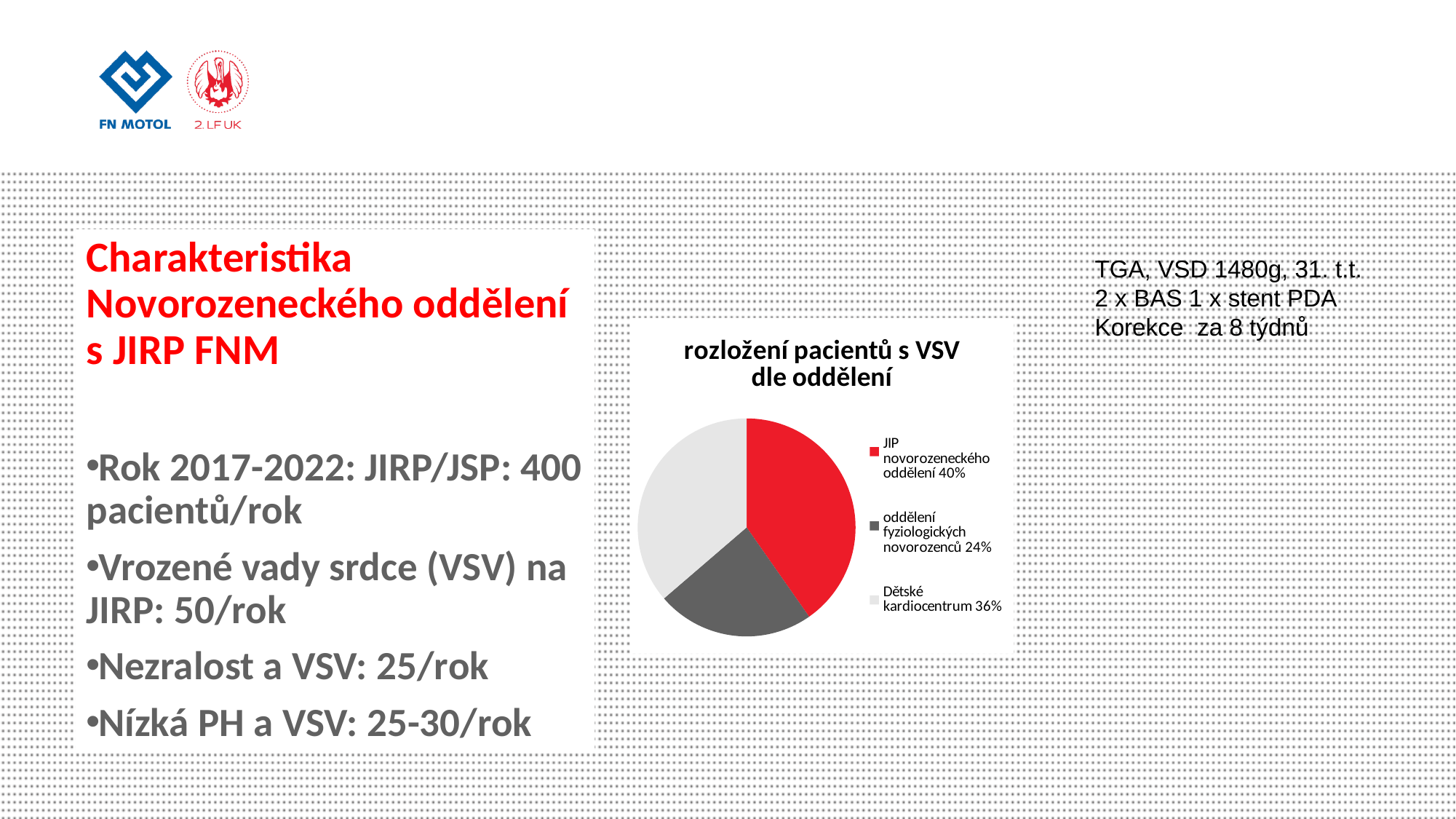
Which is larger: the share for Dětské kardiocentrum or the share for oddělení fyziologických novorozenců? Dětské kardiocentrum Which category has the largest share of the pie? JIP novorozeneckého oddělení What is the title of the pie chart? rozložení pacientů s VSV dle oddělení What kind of chart is shown on the slide? pie chart Which category has the smallest share of the pie? oddělení fyziologických novorozenců What share of the pie does oddělení fyziologických novorozenců have? 24% What is the difference in percentage points between JIP novorozeneckého oddělení and Dětské kardiocentrum? 4 What is the difference in percentage points between Dětské kardiocentrum and oddělení fyziologických novorozenců? 12 Which colour represents JIP novorozeneckého oddělení in the pie chart? red How many slices does the pie chart have? 3 What share of the pie does Dětské kardiocentrum have? 36% What share of the pie does JIP novorozeneckého oddělení have? 40%